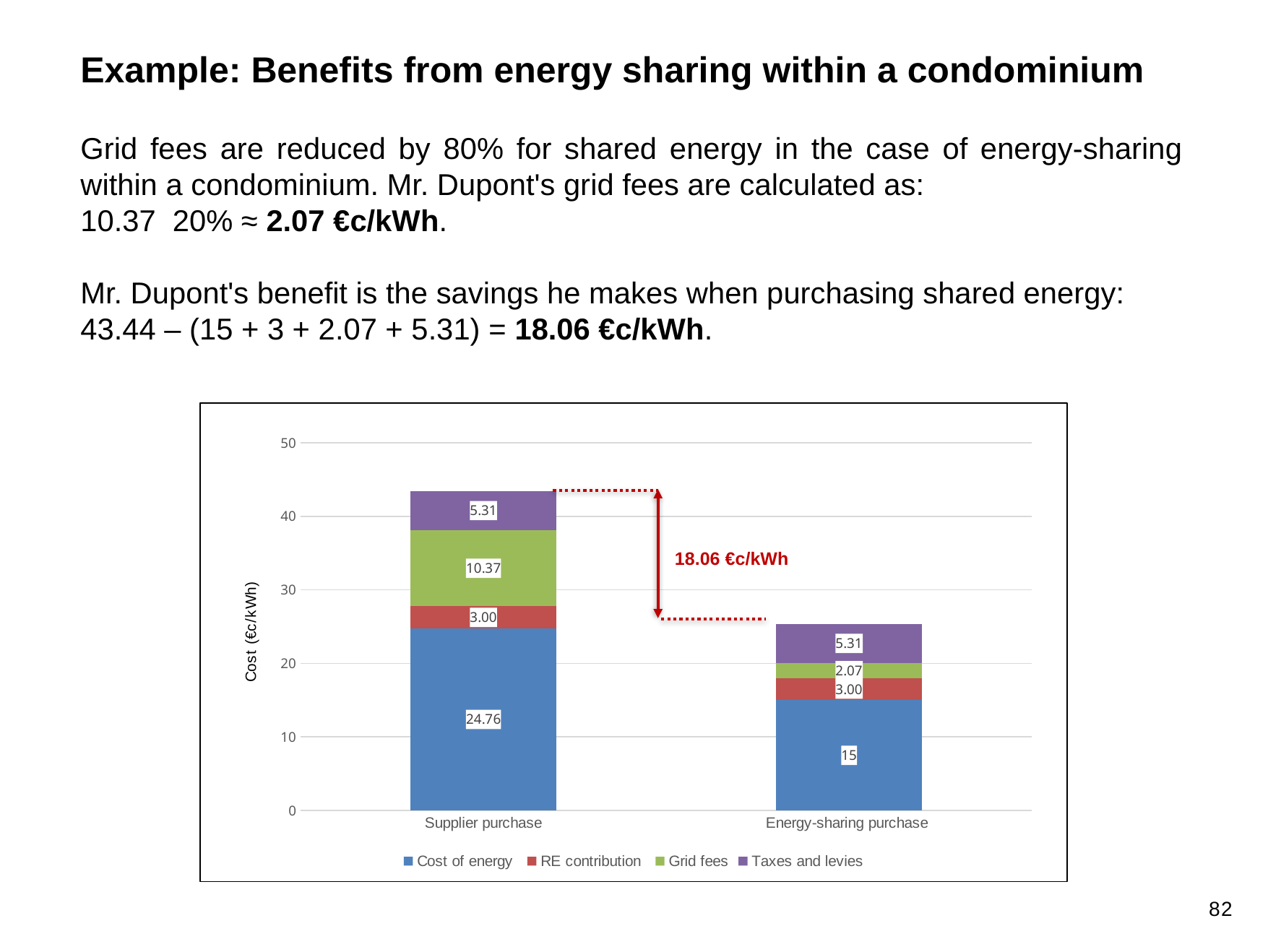
Is the total for Supplier purchase greater or less than 40? greater What is the Grid fees value for Energy-sharing purchase? 2.07 What is the total of the stacked bar for Energy-sharing purchase? 25.38 Which category has the higher total cost, Supplier purchase or Energy-sharing purchase? Supplier purchase What is the Cost of energy value for Energy-sharing purchase? 15 What is the label on the y axis of the chart? Cost (€c/kWh) What is the difference in Grid fees between Supplier purchase and Energy-sharing purchase? 8.30 What is the Cost of energy value for Supplier purchase? 24.76 How many categories are shown on the x axis of the chart? 2 What is the Taxes and levies value for Supplier purchase? 5.31 What kind of chart is shown on the slide? Stacked bar chart How many series does the chart legend list? 4